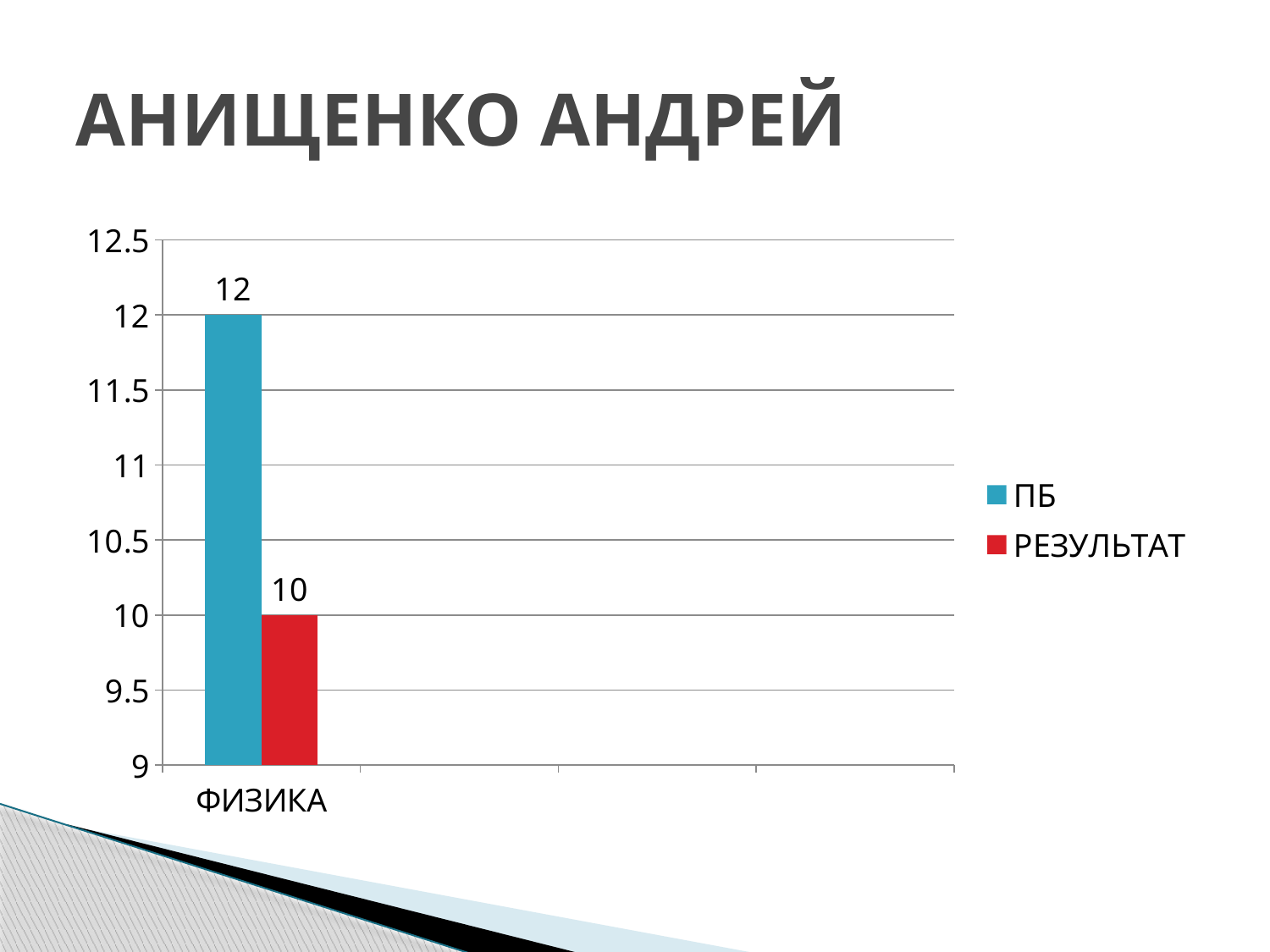
What colour is the bar for the РЕЗУЛЬТАТ series? red What kind of chart is shown on the slide? bar chart Is the value of РЕЗУЛЬТАТ for ФИЗИКА greater or less than 11? less What is the value of ПБ for ФИЗИКА? 12 What is the name of the only category on the x axis? ФИЗИКА Which series has the higher value for ФИЗИКА, ПБ or РЕЗУЛЬТАТ? ПБ How many series does the legend list? 2 Is the value of ПБ for ФИЗИКА greater or less than 11.5? greater How many categories are shown on the x axis? 1 What is the difference between the ПБ and РЕЗУЛЬТАТ values for ФИЗИКА? 2 What is the value of РЕЗУЛЬТАТ for ФИЗИКА? 10 What is the title of the slide? АНИЩЕНКО АНДРЕЙ